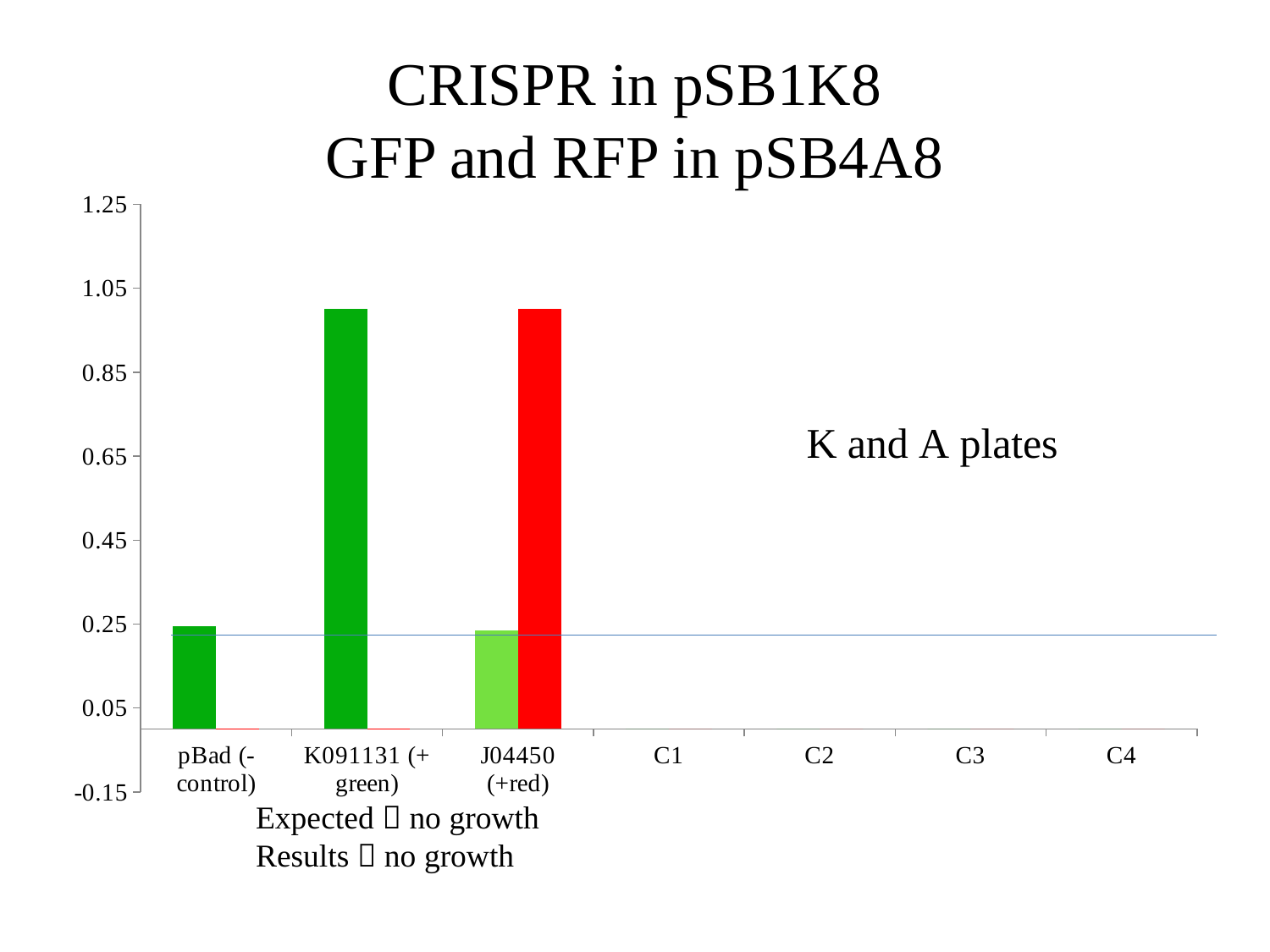
Which is larger, the value for K091131 (+green) or the value for pBad (-control)? K091131 (+green) How many categories are shown on the x axis of the chart? 7 What is the highest value shown on the y axis of the chart? 1.25 Is the value for pBad (-control) greater or less than 0.45? less What kind of chart is shown on the slide? bar chart Which categories on the chart show no visible bar? C1, C2, C3, C4 Which is larger, the red bar for J04450 (+red) or the bar for pBad (-control)? J04450 (+red) Is the value of the light green bar for J04450 (+red) greater or less than 0.45? less Is the value for K091131 (+green) greater or less than 0.85? greater What is the title of the slide containing the chart? CRISPR in pSB1K8 GFP and RFP in pSB4A8